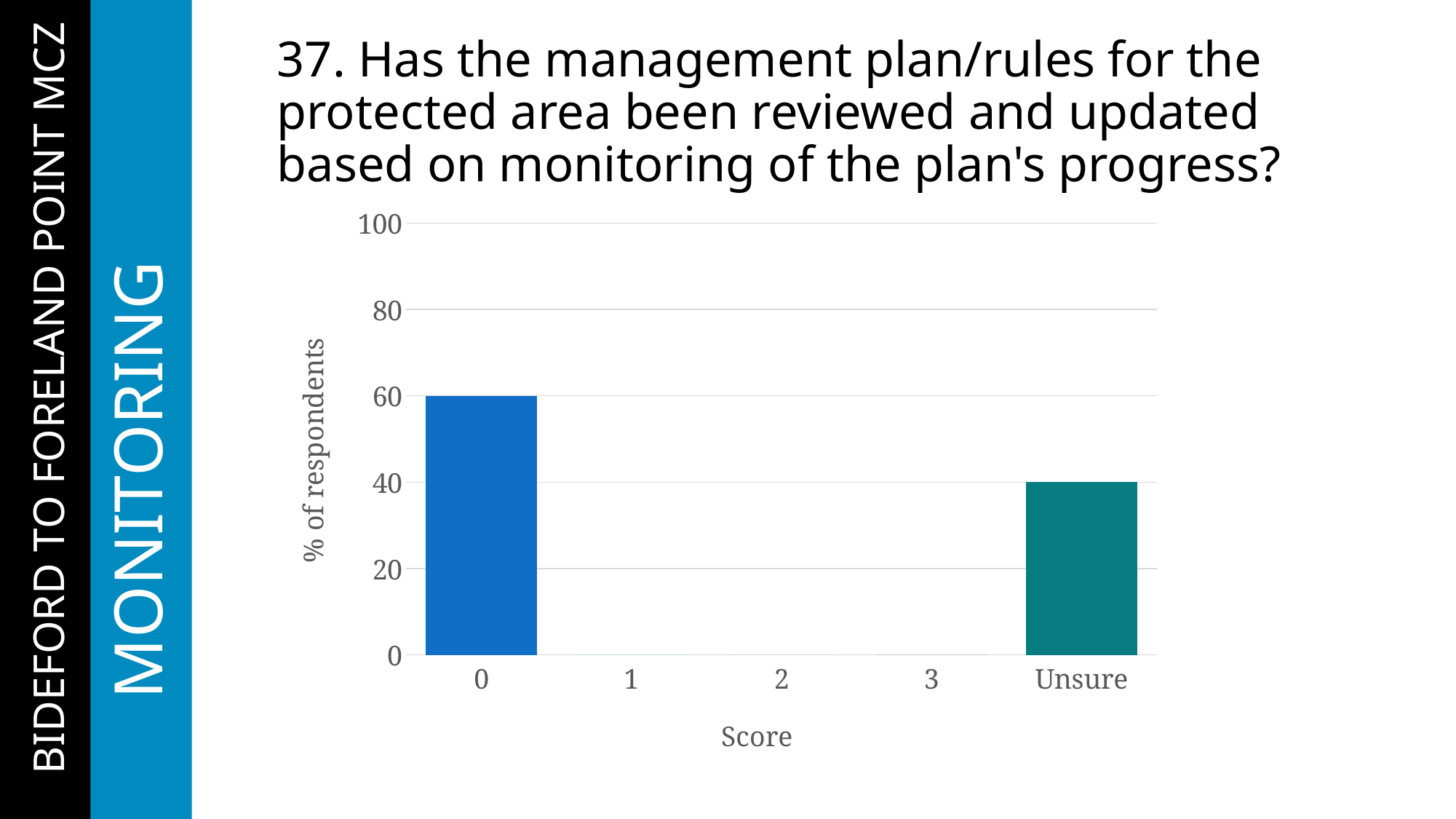
Which has a larger percentage of respondents, score 0 or Unsure? 0 What kind of chart is shown on the slide? bar chart What is the label of the x axis? Score What percentage of respondents gave a score of 0? 60 What percentage of respondents answered Unsure? 40 Which score categories have no visible bar? 1, 2 and 3 What is the difference in percentage of respondents between score 0 and Unsure? 20 Is the value for score 0 greater or less than 40? greater Is the value for Unsure greater or less than 60? less What is the label of the y axis? % of respondents Which score category has the highest percentage of respondents? 0 How many categories are shown on the x axis? 5